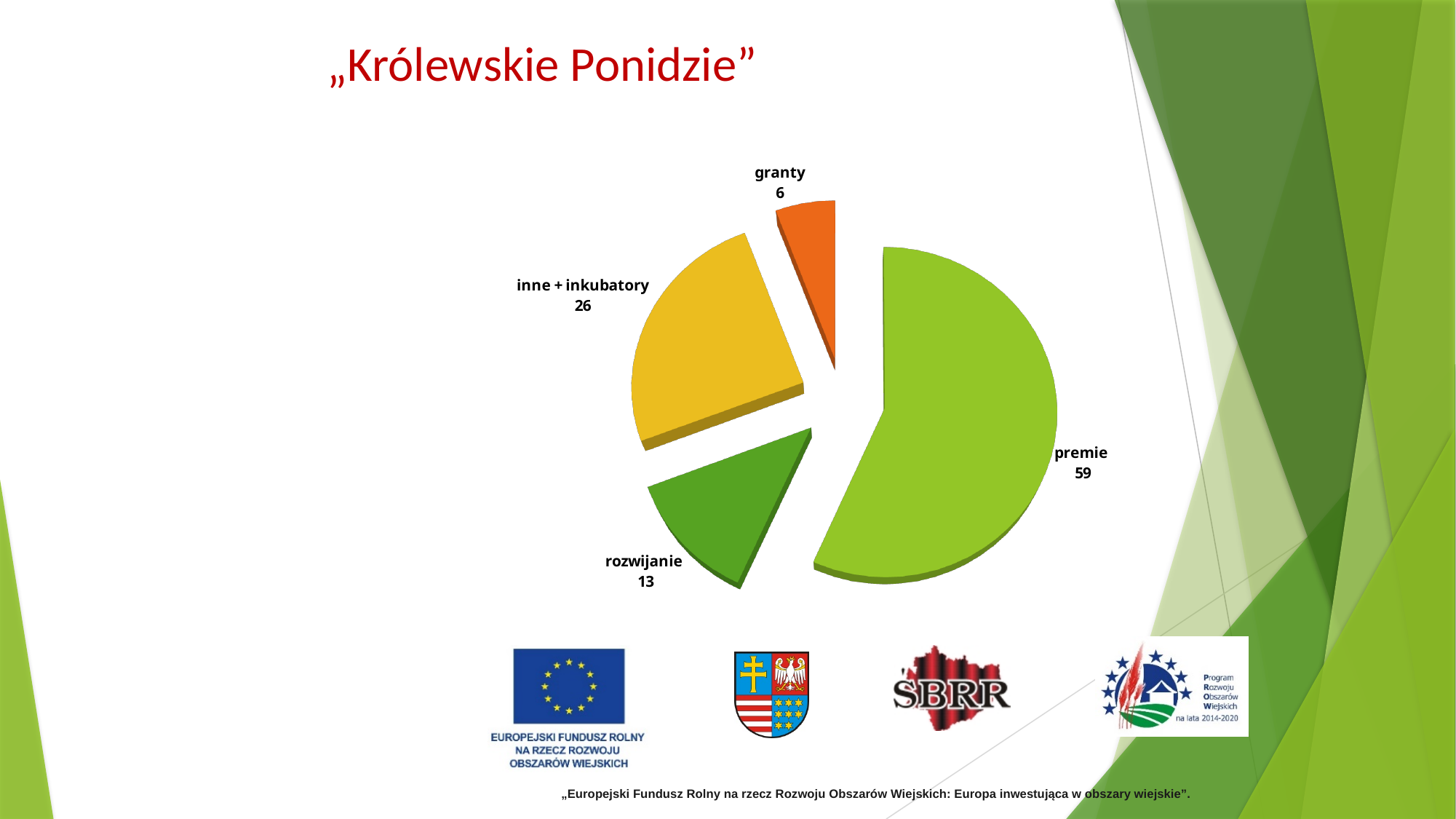
What is the sum of all four slice values in the pie chart? 104 Which category has the largest slice in the pie chart? premie Which category has the smallest slice in the pie chart? granty What is the value of the "inne + inkubatory" slice in the pie chart? 26 What is the value of the "premie" slice in the pie chart? 59 How many slices does the pie chart have? 4 What is the difference between the values for "premie" and "inne + inkubatory"? 33 What kind of chart is shown on the slide? pie chart Which is larger, the value for "rozwijanie" or the value for "inne + inkubatory"? inne + inkubatory What is the value of the "granty" slice in the pie chart? 6 What is the title shown at the top of the slide? „Królewskie Ponidzie” What is the value of the "rozwijanie" slice in the pie chart? 13